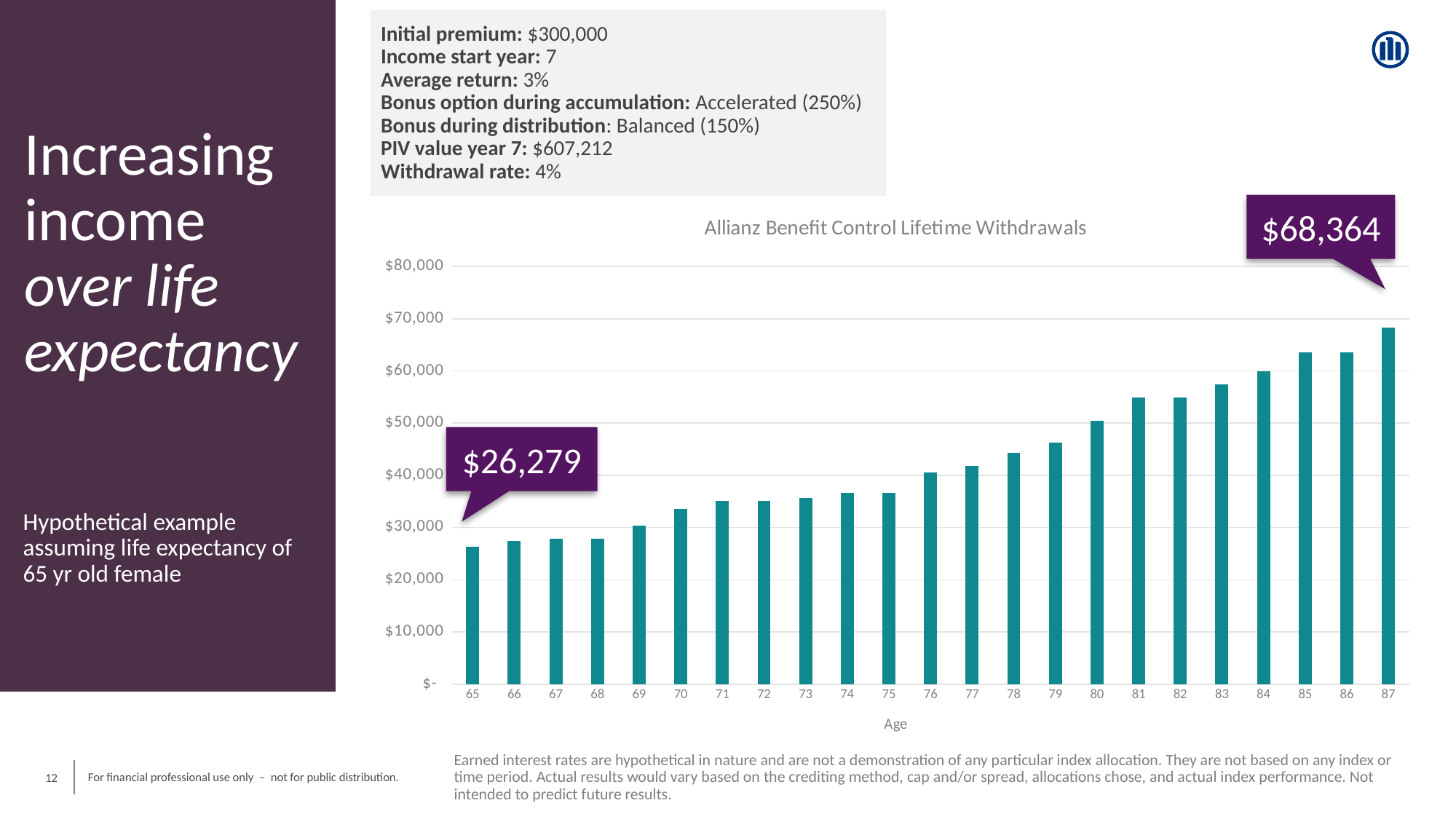
What is the withdrawal value shown for age 87? $68,364 Which has the larger withdrawal value, age 70 or age 80? age 80 What type of chart is shown on the slide? bar chart Is the withdrawal value for age 75 greater or less than $40,000? less Is the withdrawal value for age 85 greater or less than $60,000? greater Do the withdrawal values generally rise or fall as age increases? rise What is the difference between the withdrawal at age 87 and the withdrawal at age 65? $42,085 How many ages (bars) are plotted on the chart? 23 At which age is the withdrawal highest? 87 What is the withdrawal value shown for age 65? $26,279 At which age is the withdrawal lowest? 65 What is the title of the chart? Allianz Benefit Control Lifetime Withdrawals